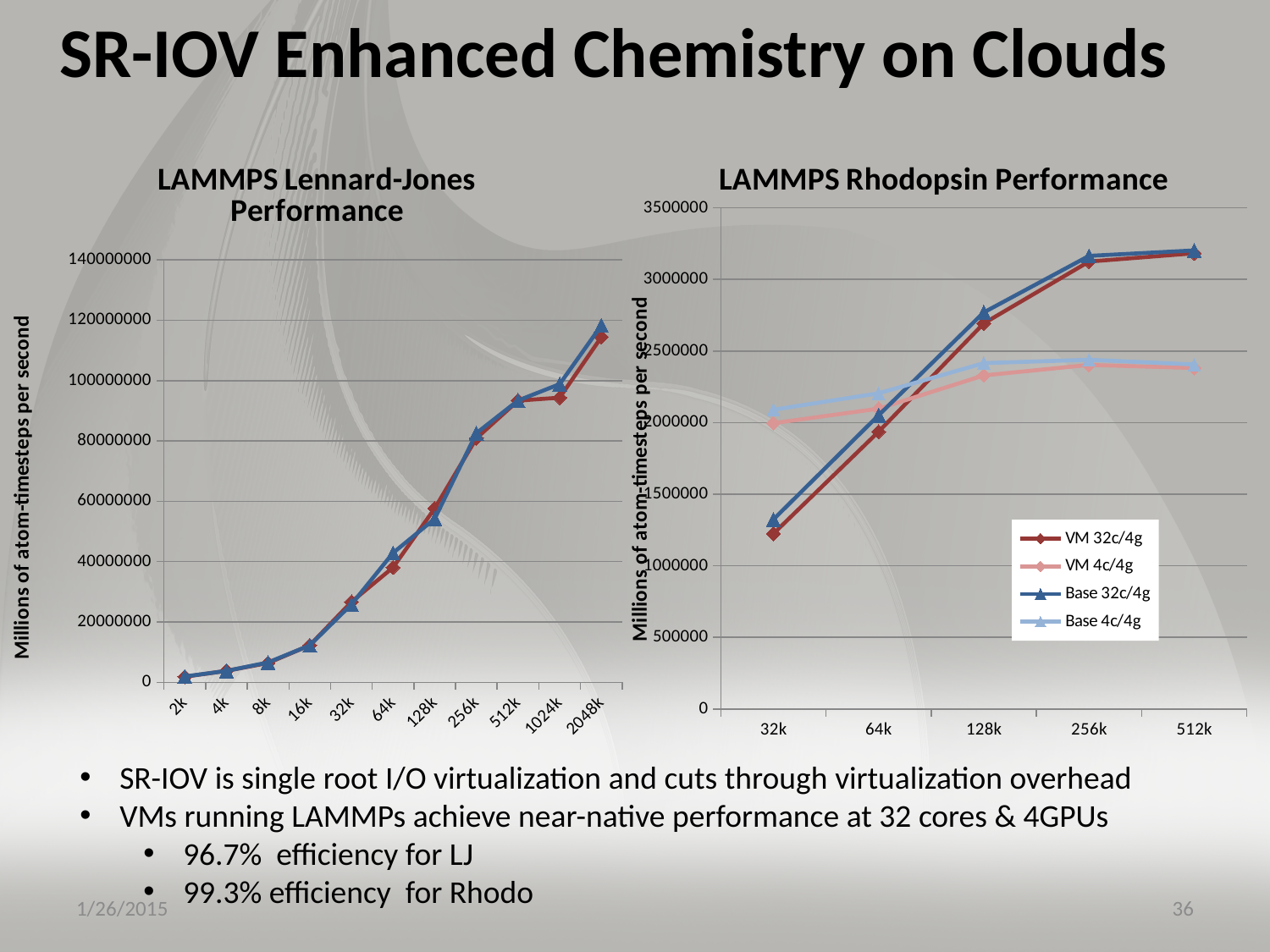
How many categories are on the x axis of the LAMMPS Rhodopsin Performance chart? 5 In the LAMMPS Rhodopsin Performance chart, is the value for VM 4c/4g at 32k greater or less than 2500000? less In the LAMMPS Rhodopsin Performance chart, at 512k, which is larger: Base 32c/4g or Base 4c/4g? Base 32c/4g What is the y-axis label of the LAMMPS Rhodopsin Performance chart? Millions of atom-timesteps per second What type of chart is the LAMMPS Rhodopsin Performance chart? line chart How many categories are on the x axis of the LAMMPS Lennard-Jones Performance chart? 11 In the LAMMPS Rhodopsin Performance chart, is the value for Base 32c/4g at 512k greater or less than 3000000? greater How many series does the legend of the LAMMPS Rhodopsin Performance chart list? 4 In the LAMMPS Lennard-Jones Performance chart, is the value at 2048k greater or less than 100000000? greater In the LAMMPS Lennard-Jones Performance chart, do the values rise or fall as the x axis goes from 2k to 2048k? rise What type of chart is the LAMMPS Lennard-Jones Performance chart? line chart In the LAMMPS Rhodopsin Performance chart, which series has the lowest value at 32k? VM 32c/4g